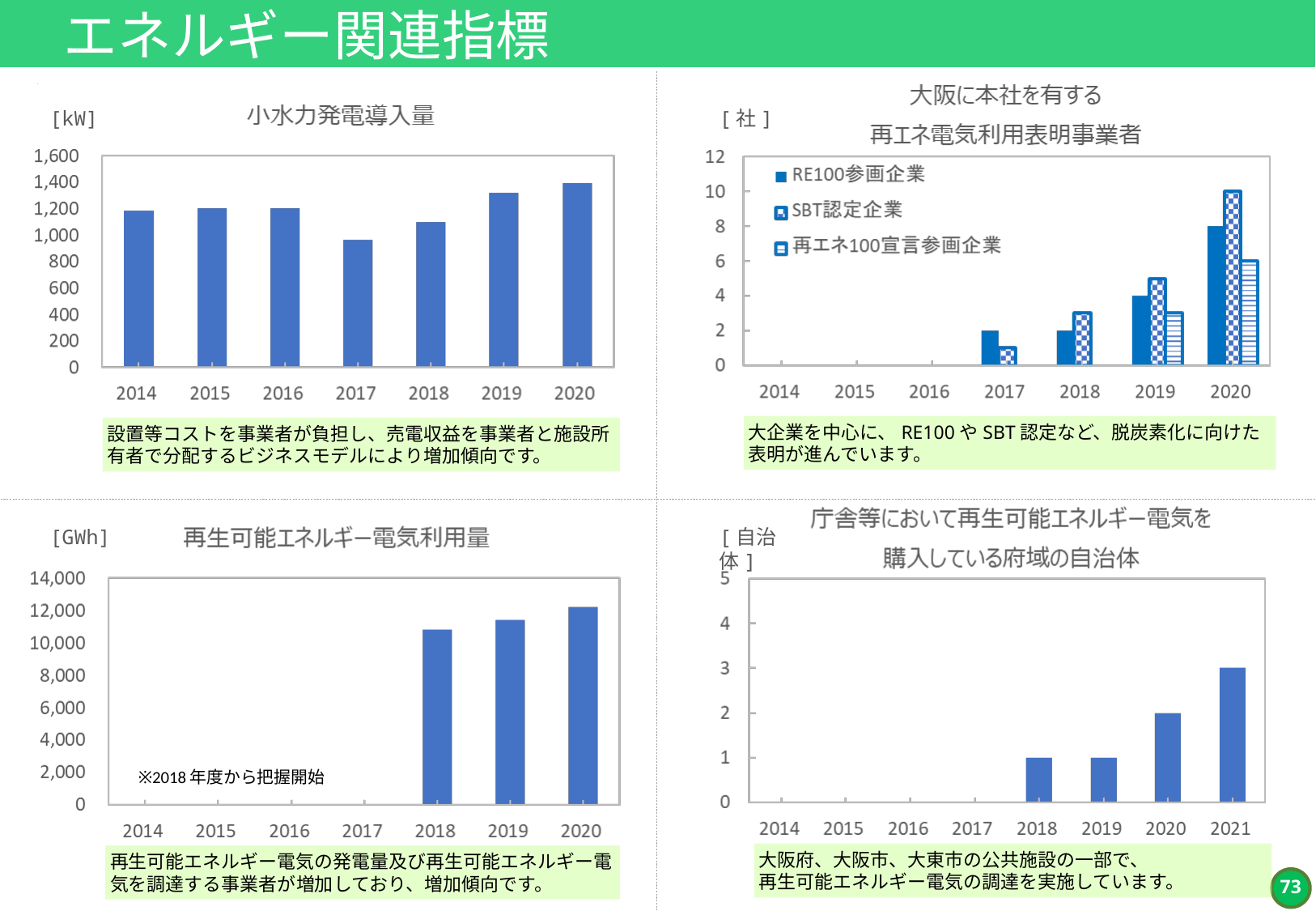
In the 小水力発電導入量 chart (top left), which year has the highest value? 2020 In the 大阪に本社を有する再エネ電気利用表明事業者 chart (top right), what is the difference between SBT認定企業 and 再エネ100宣言参画企業 in 2019? 2 In the 再生可能エネルギー電気利用量 chart (bottom left), do the values rise or fall from 2018 to 2020? rise In the 庁舎等において再生可能エネルギー電気を購入している府域の自治体 chart (bottom right), what is the value for 2021? 3 What kind of chart is the 庁舎等において再生可能エネルギー電気を購入している府域の自治体 chart (bottom right)? bar chart In the 大阪に本社を有する再エネ電気利用表明事業者 chart (top right), how many series does the legend list? 3 In the 小水力発電導入量 chart (top left), what unit is shown on the vertical axis? kW In the 大阪に本社を有する再エネ電気利用表明事業者 chart (top right), what is the value for RE100参画企業 in 2020? 8 In the 大阪に本社を有する再エネ電気利用表明事業者 chart (top right), what is the value for SBT認定企業 in 2020? 10 In the 小水力発電導入量 chart (top left), which year has the lowest value? 2017